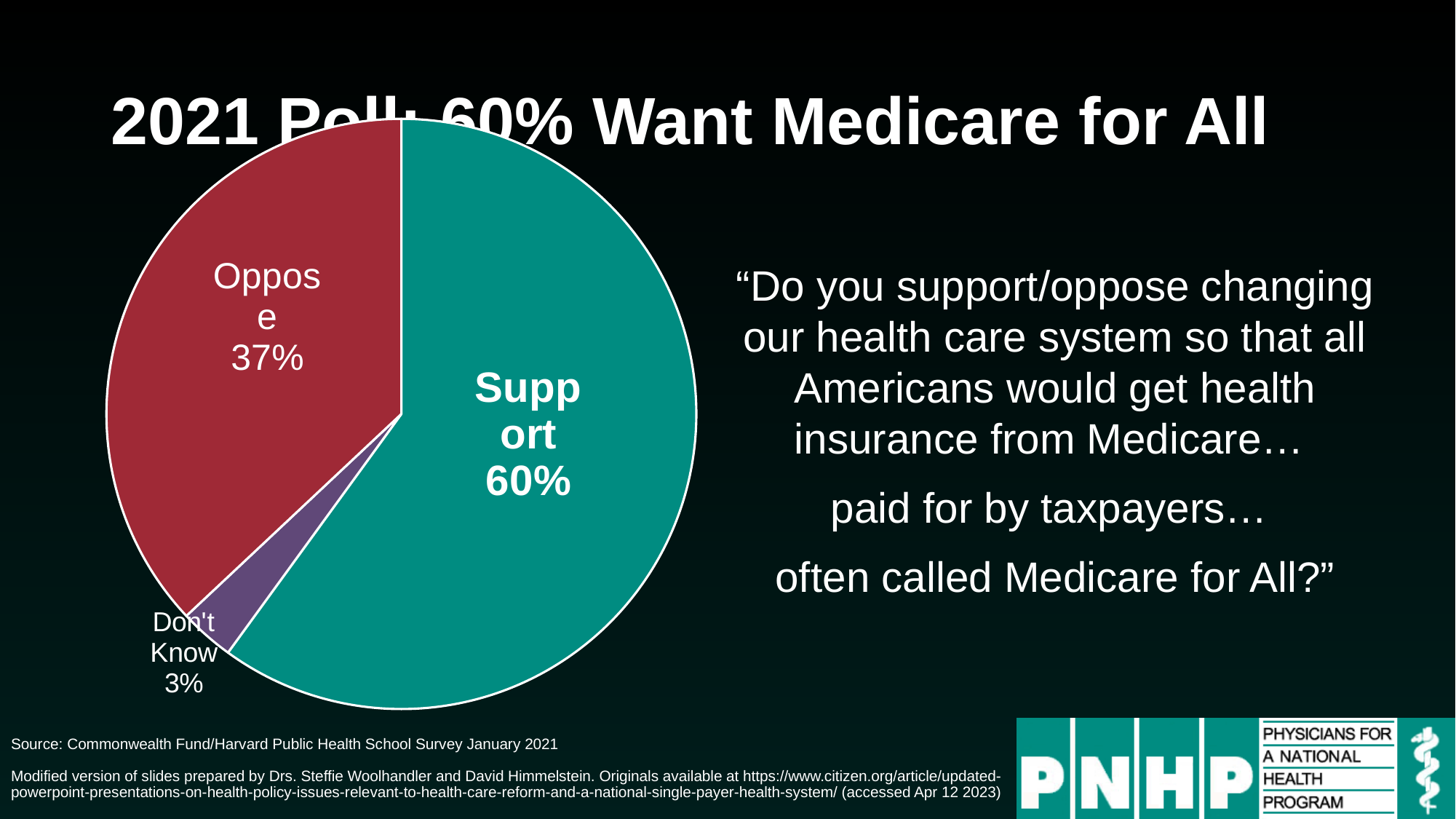
What share of the pie does the Support slice represent? 60% What is the title of the slide containing the pie chart? 2021 Poll: 60% Want Medicare for All What kind of chart is shown on the slide? Pie chart Which is larger in the pie chart, Oppose or Don't Know? Oppose Which response has the largest slice of the pie chart? Support What percentage of respondents answered Don't Know in the pie chart? 3% What colour is the Support slice in the pie chart? Teal What percentage of respondents oppose Medicare for All according to the pie chart? 37% What percentage of respondents support Medicare for All according to the pie chart? 60% What is the difference in percentage points between Support and Oppose in the pie chart? 23 How many slices does the pie chart have? 3 Which response has the smallest slice of the pie chart? Don't Know